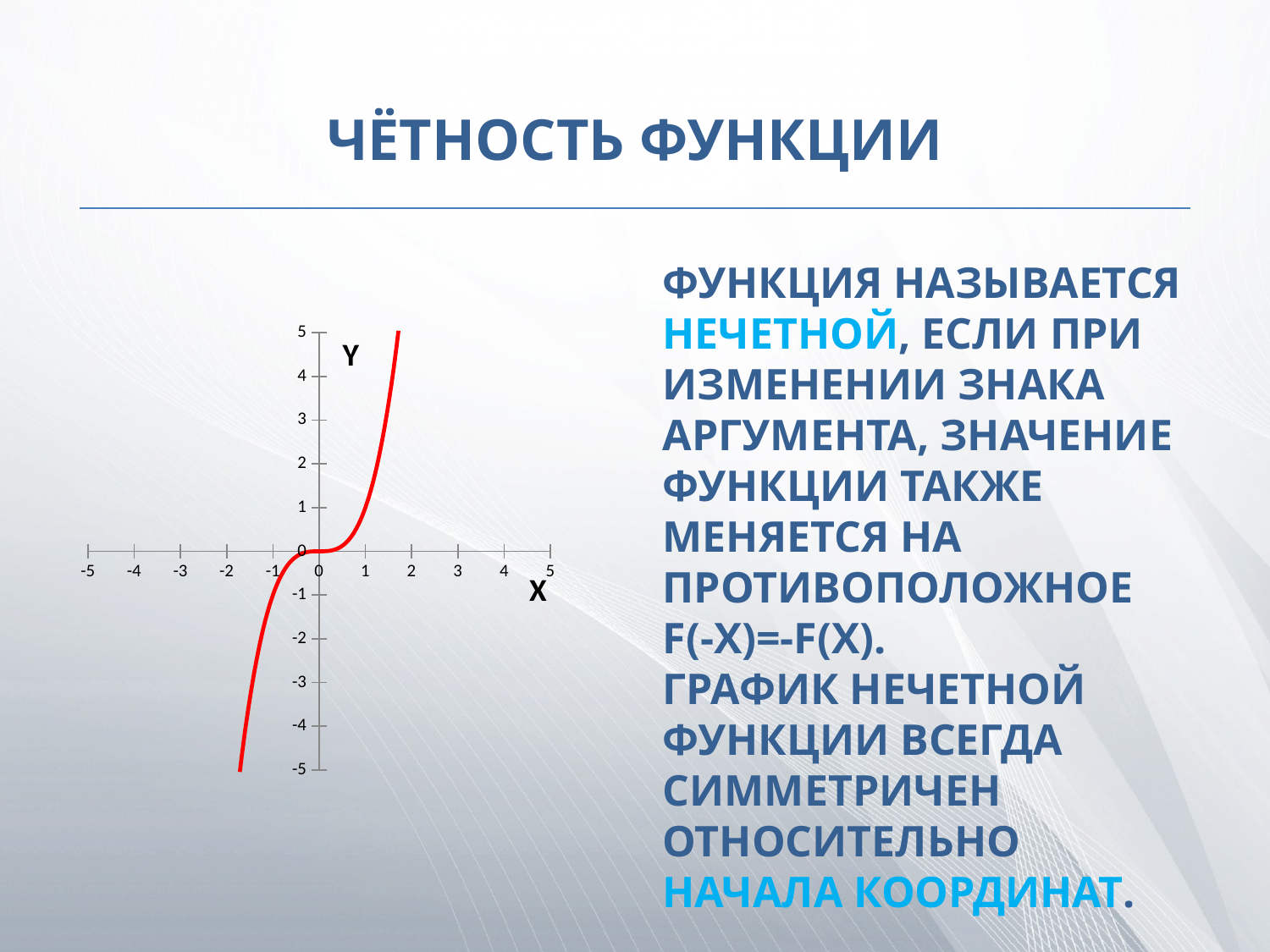
What is the lowest value labelled on the y axis of the chart? -5 What kind of chart is shown on the slide? line chart Is the value of the function at x = 1 greater or less than 0? greater Do the values on the chart rise or fall as x increases from left to right? rise Is the value of the function at x = -1 greater or less than 0? less Which of the two is larger: the function value at x = 1 or at x = -1? x = 1 What is the highest value labelled on the x axis of the chart? 5 What colour is the curve plotted on the chart? red